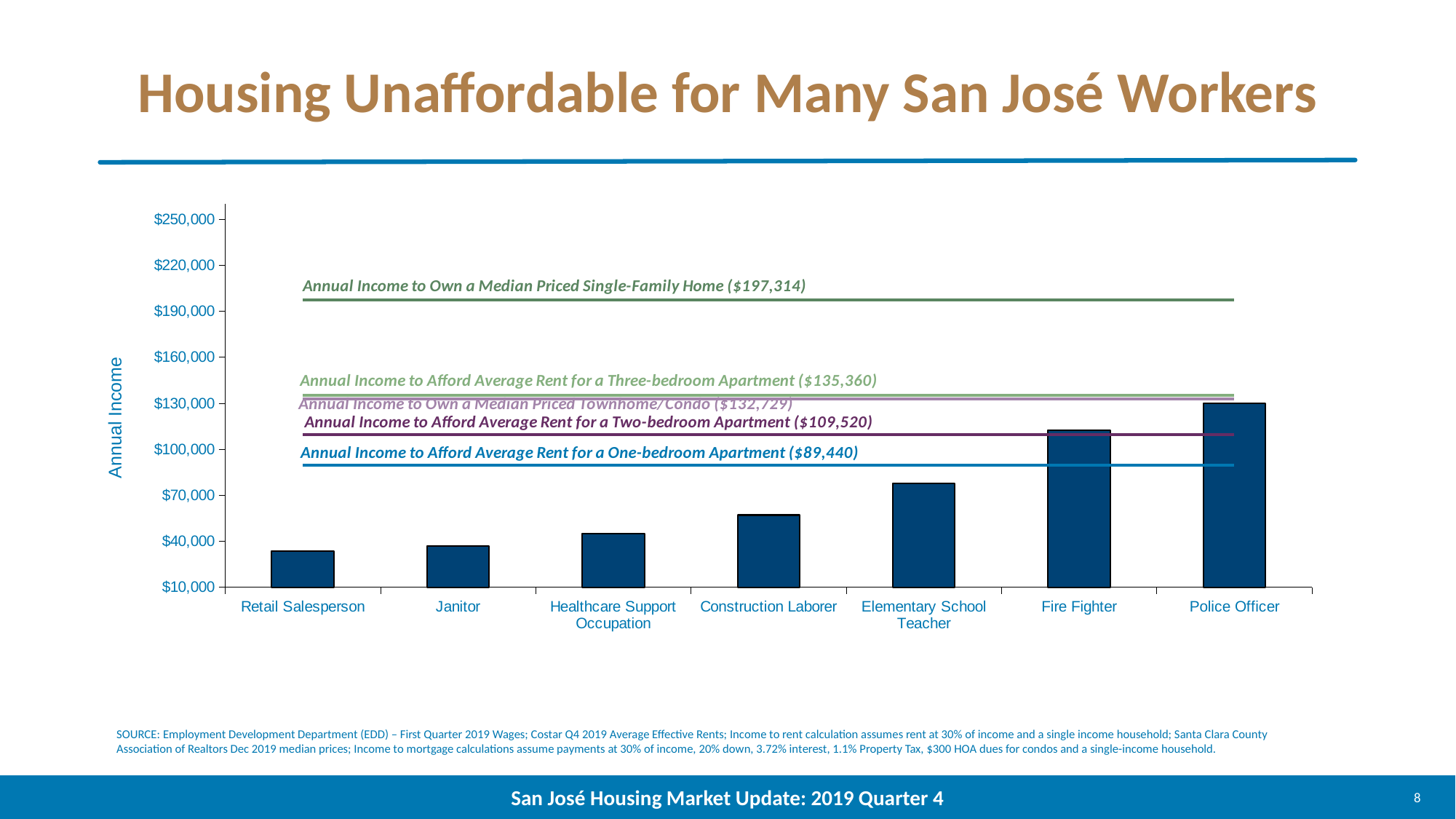
What is the label on the vertical axis of the chart? Annual Income Which occupation has the highest annual income on the chart? Police Officer According to the reference line, what annual income is needed to own a median priced single-family home? $197,314 Is the annual income for Retail Salesperson greater or less than $40,000? less What is the difference between the annual income needed to afford average rent for a two-bedroom apartment ($109,520) and a one-bedroom apartment ($89,440)? $20,080 Do the bar values rise or fall moving from left to right across the occupations? Rise Which occupation has the lowest annual income on the chart? Retail Salesperson What kind of chart is shown on the slide? Bar chart Is the annual income for Police Officer greater or less than $100,000? greater How many occupations are plotted as bars on the chart? 7 Which is larger, the annual income for Fire Fighter or for Construction Laborer? Fire Fighter Is the annual income for Elementary School Teacher greater or less than $100,000? less